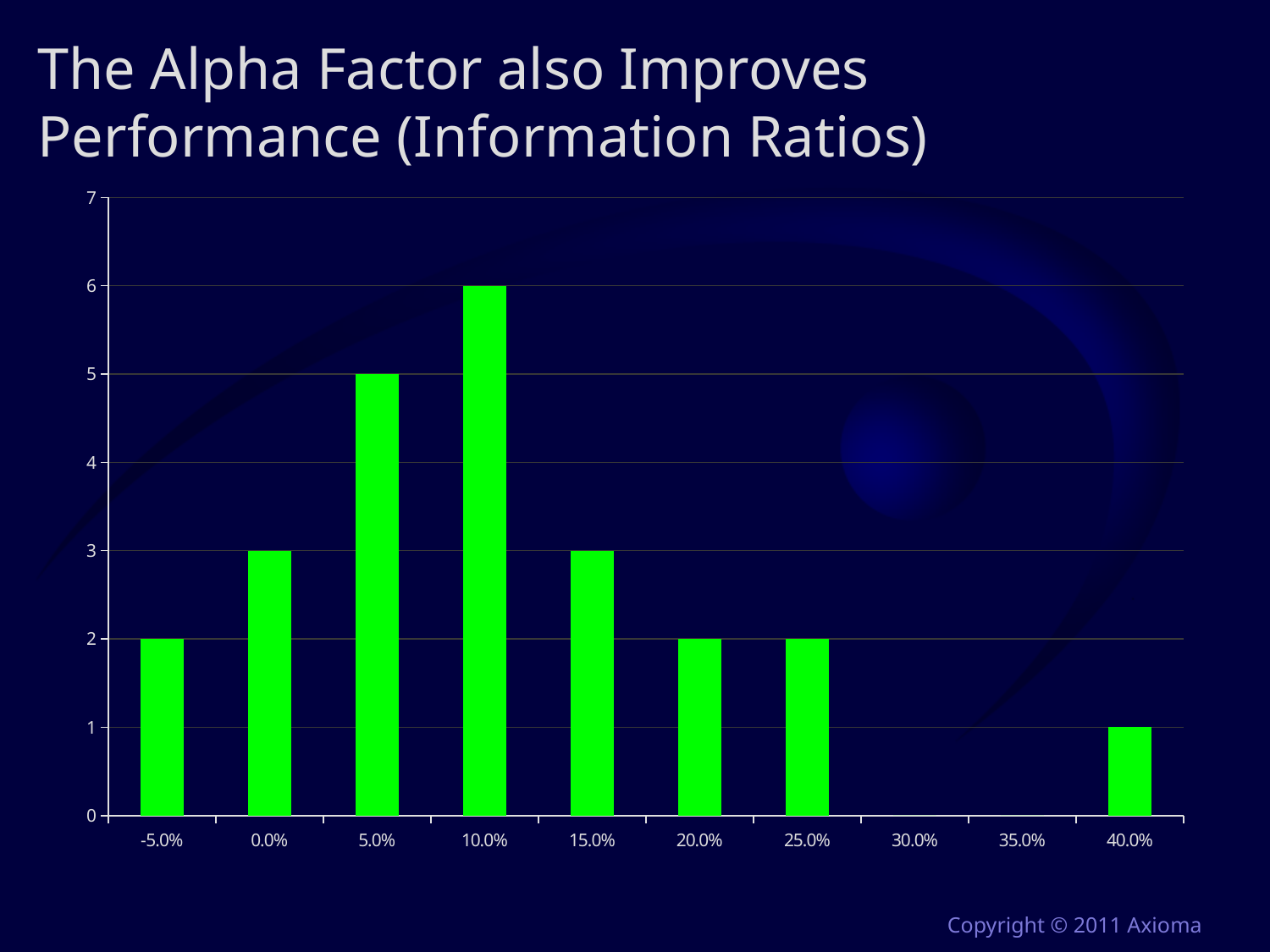
What is the value of the bar at 10.0%? 6 What is the value of the bar at -5.0%? 2 What colour are the bars in the chart? green What kind of chart is shown on the slide? bar chart How many categories are labelled on the x axis? 10 What is the difference between the bar at 10.0% and the bar at 15.0%? 3 Is the value of the bar at 5.0% greater or less than 4? greater Which category has the tallest bar? 10.0% What is the value of the bar at 5.0%? 5 Which is larger, the bar at 0.0% or the bar at 20.0%? 0.0% Do the bar values rise or fall from 10.0% to 25.0%? fall What is the value of the bar at 40.0%? 1